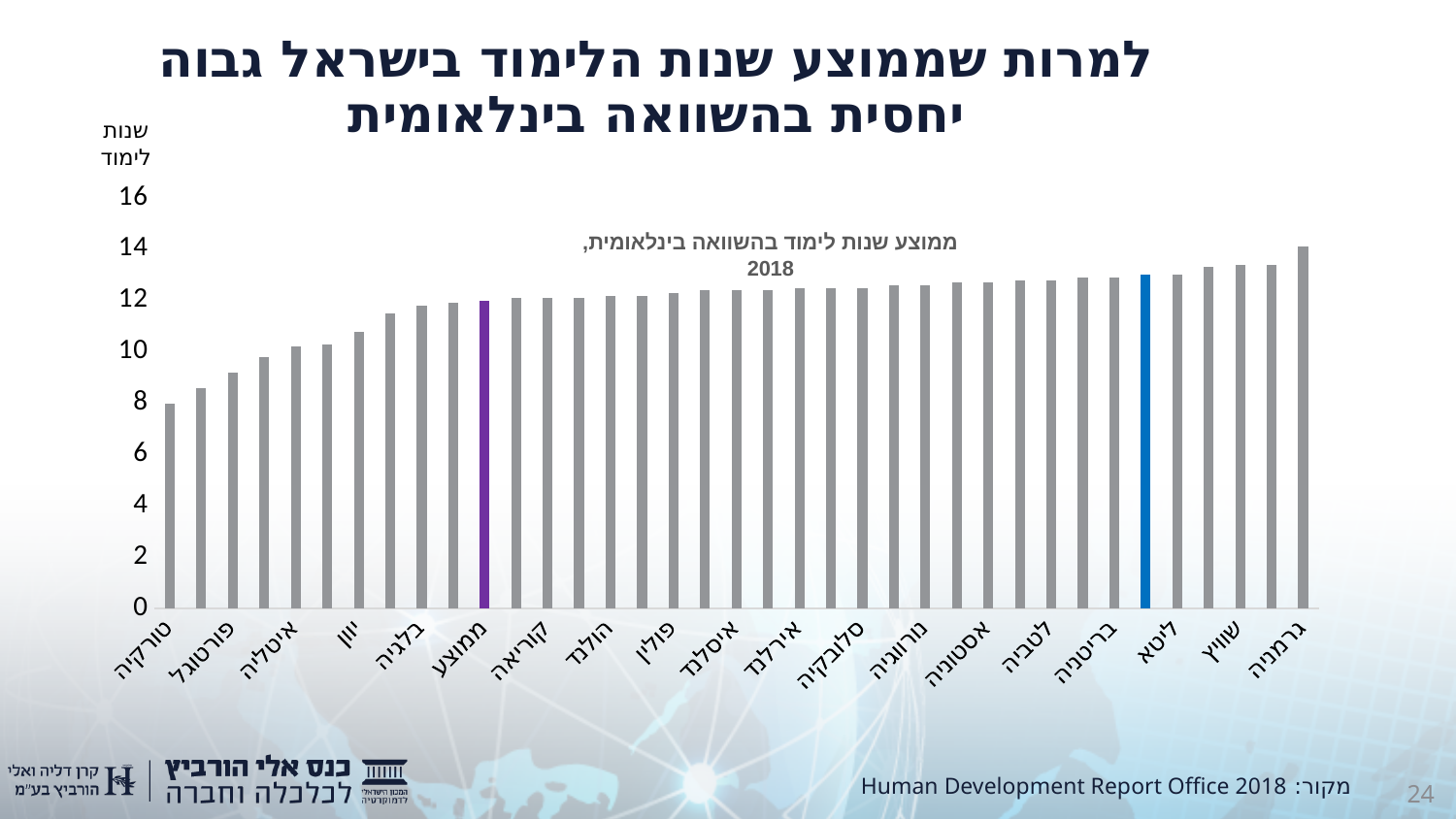
Is the value for טורקיה greater or less than 6? greater Which has a higher value, שוויץ or איטליה? שוויץ Is the value for פורטוגל greater or less than 8? greater What is the title of the chart? ממוצע שנות לימוד בהשוואה בינלאומית, 2018 Which country has the lowest average years of schooling in the chart? טורקיה Is the value for יוון greater or less than 10? greater Which country has the highest average years of schooling in the chart? גרמניה Do the bar values rise or fall moving from left to right along the x axis? rise What kind of chart is shown on the slide? bar chart What colour is the bar for ממוצע? purple